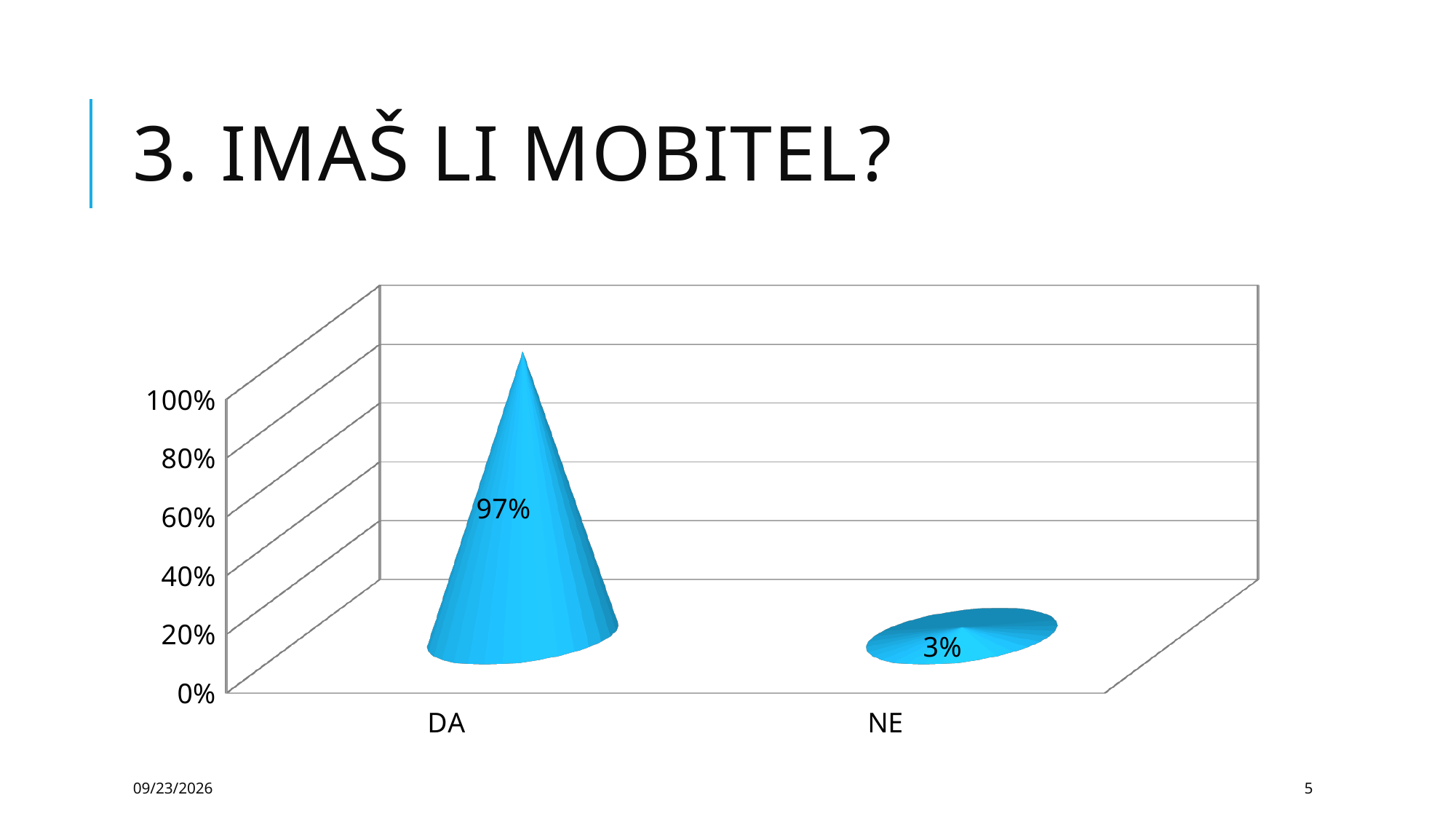
What is the title of the slide containing the chart? 3. IMAŠ LI MOBITEL? Which is larger, the value for DA or the value for NE? DA What kind of chart is shown on the slide? bar chart What is the value for DA? 97% What is the value for NE? 3% Which category has the highest value? DA Is the value for NE greater or less than 20%? less Is the value for DA greater or less than 80%? greater Which category has the lowest value? NE What is the difference between the values for DA and NE? 94% What is the highest value labelled on the vertical axis? 100% How many categories are shown on the x axis? 2